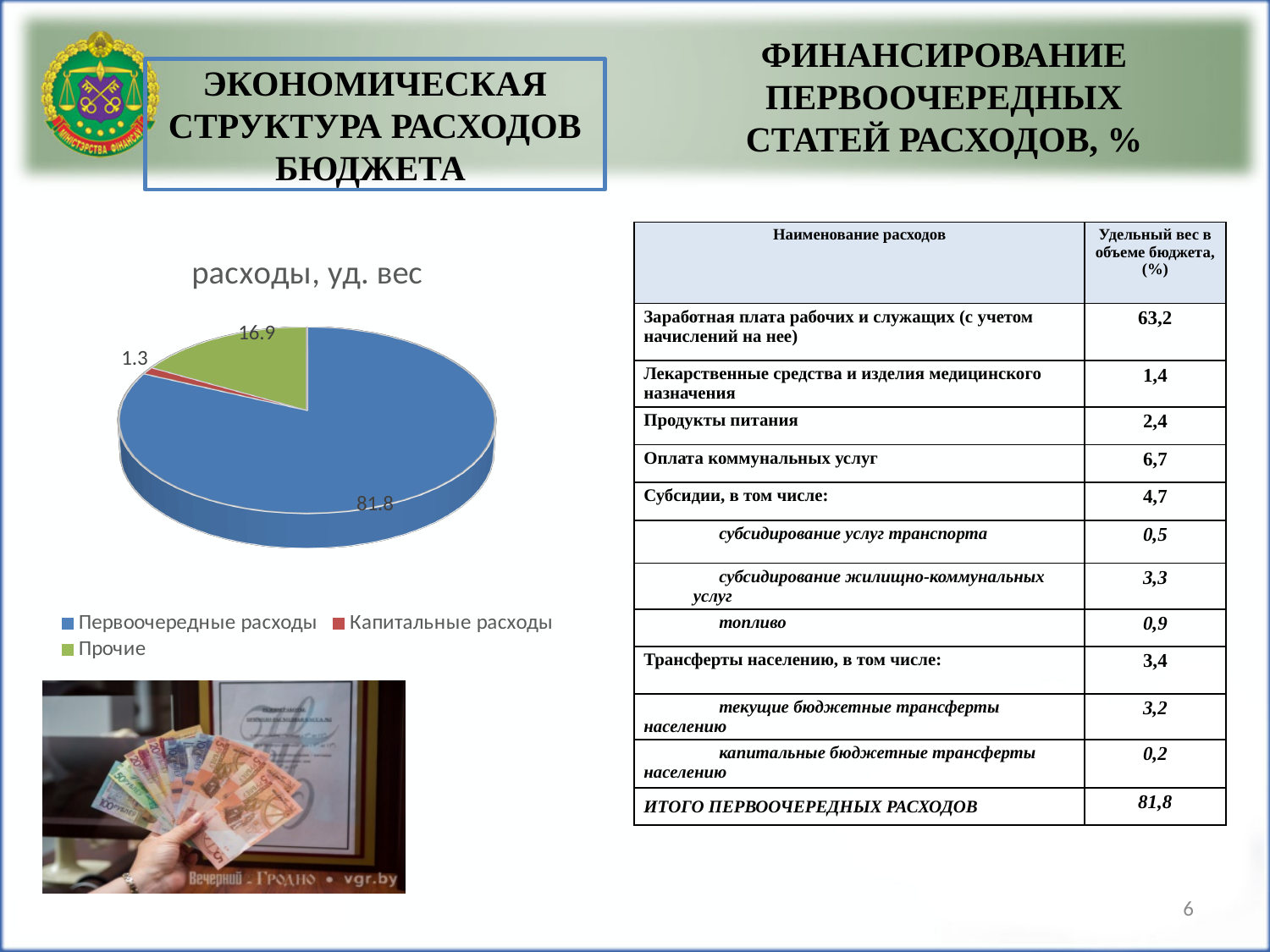
What is the value shown for Капитальные расходы in the pie chart? 1.3 In the pie chart, what is the difference between the values for Прочие and Капитальные расходы? 15.6 In the pie chart, what is the difference between the values for Первоочередные расходы and Прочие? 64.9 What type of chart is shown under the title "расходы, уд. вес"? pie chart What is the value shown for Первоочередные расходы in the pie chart? 81.8 Which category has the smallest slice in the pie chart? Капитальные расходы How many slices does the pie chart have? 3 In the pie chart, which is larger: Прочие or Капитальные расходы? Прочие Which category has the largest slice in the pie chart? Первоочередные расходы What colour is the slice for Прочие in the pie chart? green What is the value shown for Прочие in the pie chart? 16.9 How many entries does the legend of the pie chart list? 3